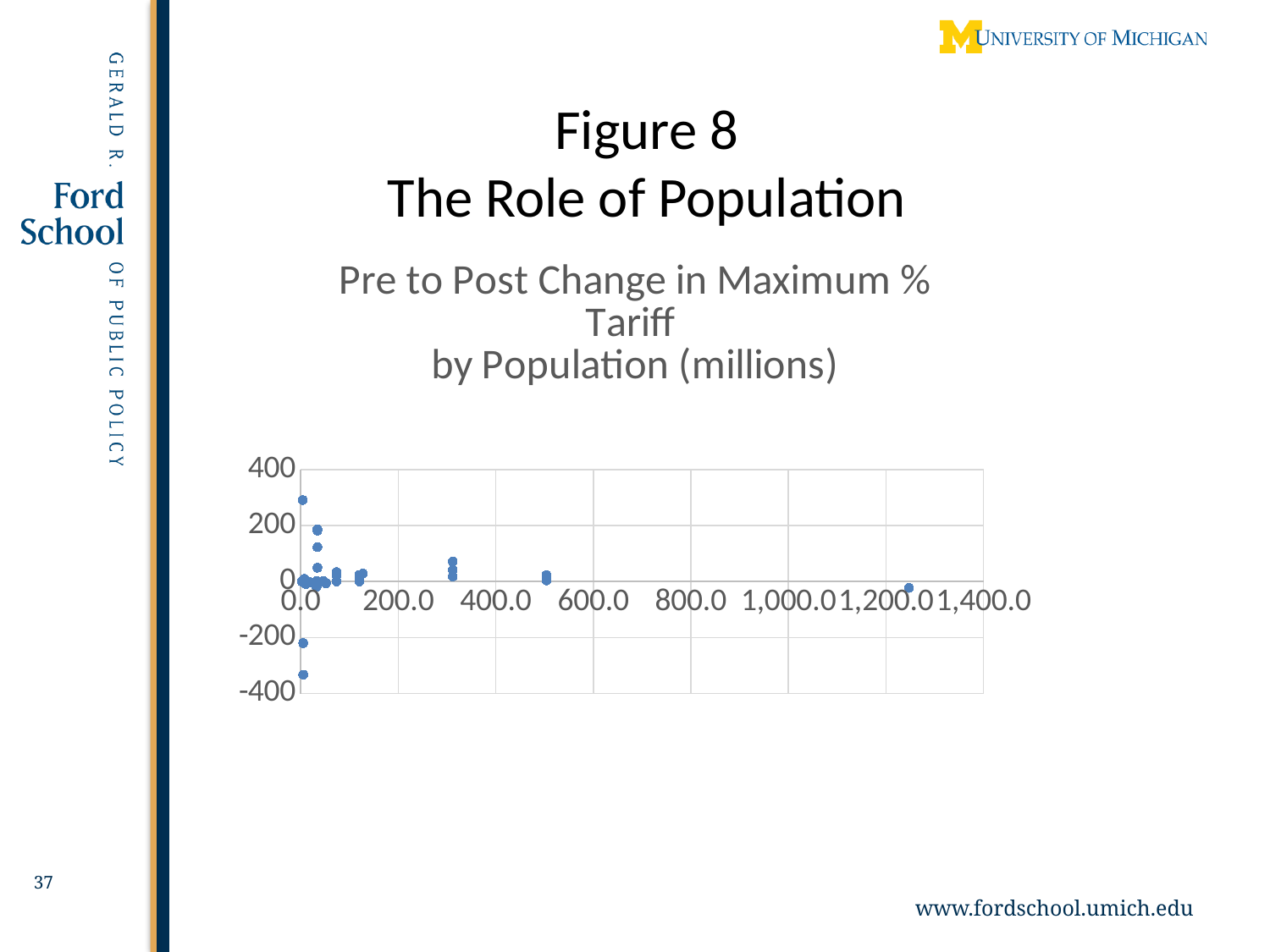
What is the title of the chart? Pre to Post Change in Maximum % Tariff by Population (millions) Is the lowest plotted point on the chart greater or less than -200 on the vertical axis? less What is the highest value shown on the vertical axis of the chart? 400 Is the population value of the rightmost plotted point greater or less than 1,000.0? greater What is the largest tick label shown on the horizontal axis of the chart? 1,400.0 Is the population value of the highest plotted point greater or less than 200.0? less What kind of chart is shown on the slide? scatter plot Are most of the plotted points located at population values below or above 200.0? below